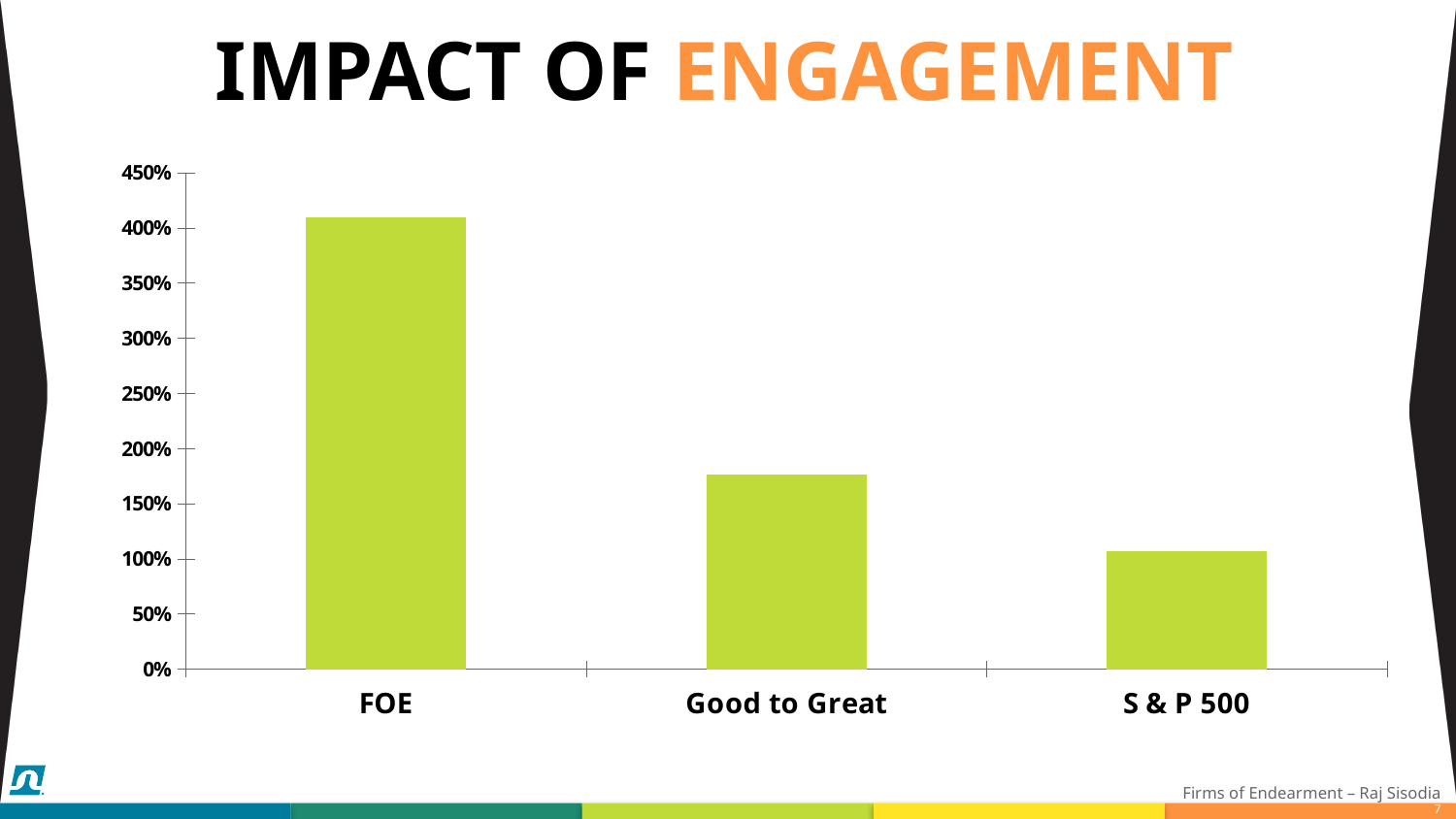
How many categories are shown on the x axis of the chart? 3 Is the value for FOE greater or less than 350%? greater Is the value for Good to Great greater or less than 200%? less Which is larger, the value for FOE or the value for Good to Great? FOE Which category has the highest value in the chart? FOE Is the value for S & P 500 greater or less than 150%? less What kind of chart is shown on the slide? bar chart Which category has the lowest value in the chart? S & P 500 Do the bar values rise or fall from left to right across the x axis? fall What is the title of the slide containing the chart? IMPACT OF ENGAGEMENT Which is larger, the value for Good to Great or the value for S & P 500? Good to Great